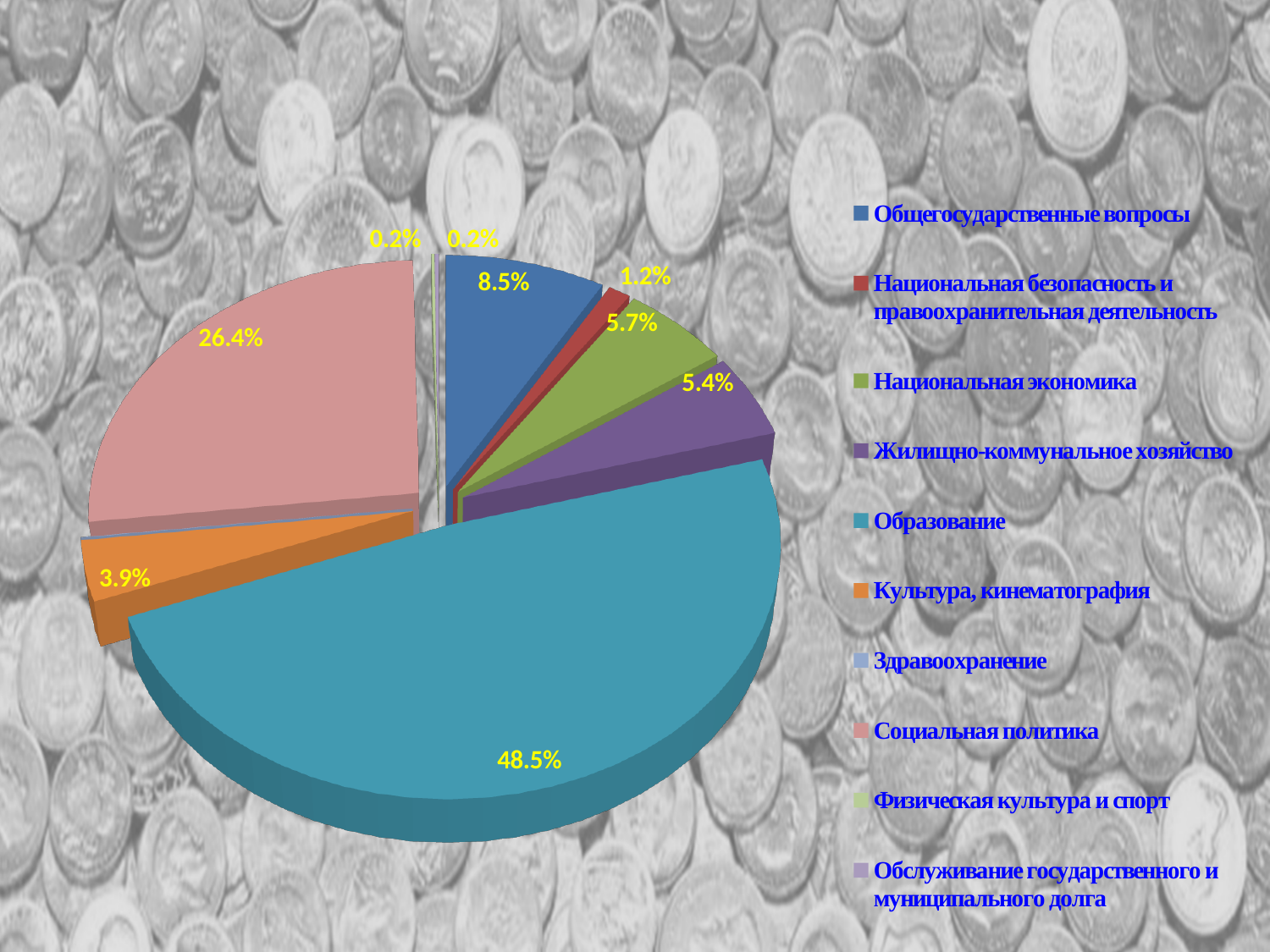
What value is shown for Социальная политика? 26.4% What value is shown for Национальная безопасность и правоохранительная деятельность? 1.2% What value is shown for Общегосударственные вопросы? 8.5% What value is shown for Жилищно-коммунальное хозяйство? 5.4% Which category has the largest slice of the pie? Образование What is the difference between the shares of Образование and Социальная политика? 22.1% What share of the pie does Образование have? 48.5% What type of chart is shown on the slide? pie chart What value is shown for Национальная экономика? 5.7% What value is shown for Культура, кинематография? 3.9% How many categories does the legend of the pie chart list? 10 Which is larger, the share for Национальная экономика or for Жилищно-коммунальное хозяйство? Национальная экономика